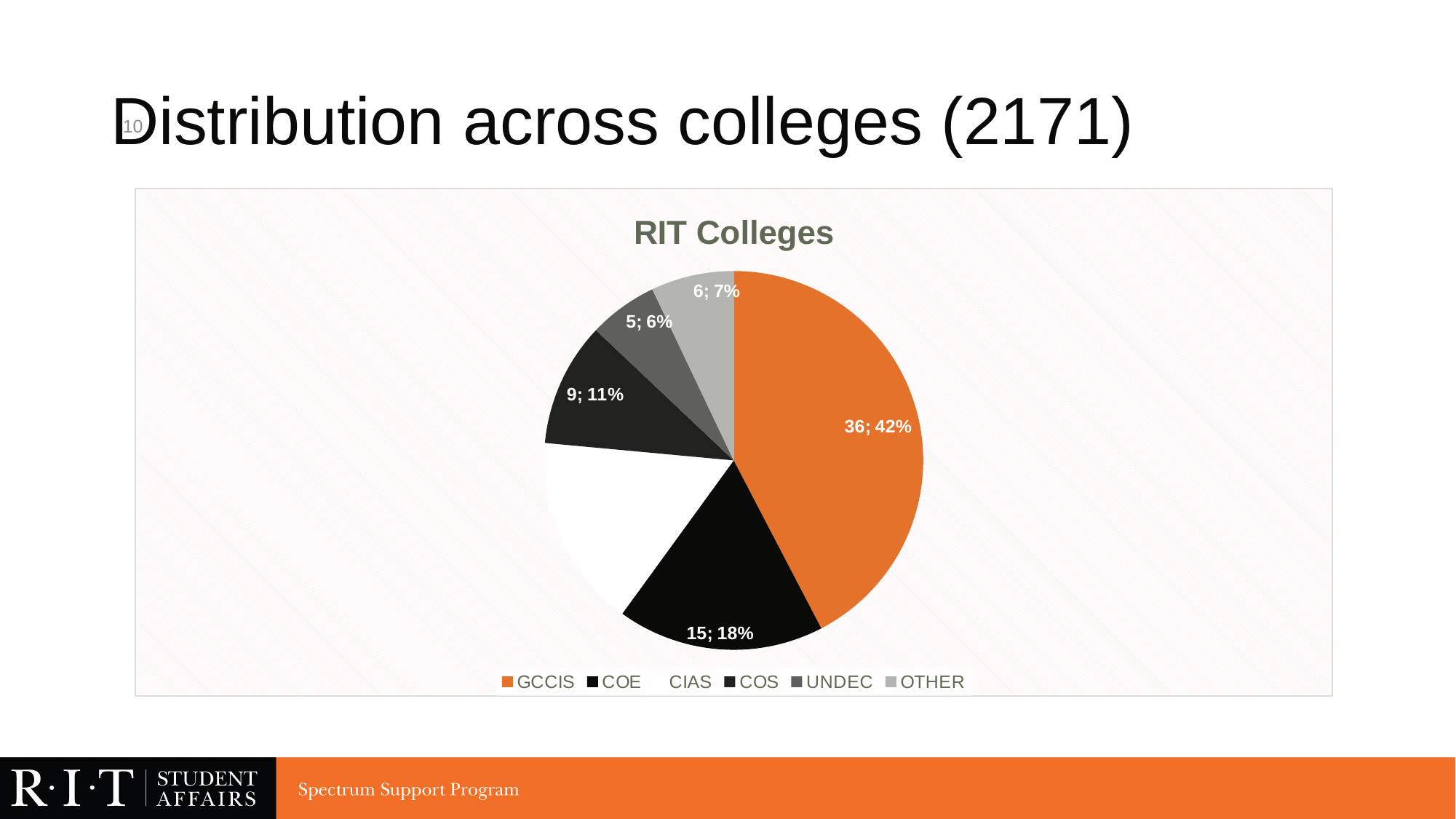
Which has the larger count, OTHER or UNDEC? OTHER What percentage share of the pie does GCCIS have? 42% What is the count shown for UNDEC? 5 Which college has the largest slice of the pie? GCCIS What percentage share of the pie does OTHER have? 7% What percentage share of the pie does COS have? 11% What is the chart's title? RIT Colleges What is the difference between the counts for GCCIS and COE? 21 What is the count shown for GCCIS? 36 What kind of chart is shown on the slide? pie chart What is the count shown for COE? 15 How many categories does the legend list? 6